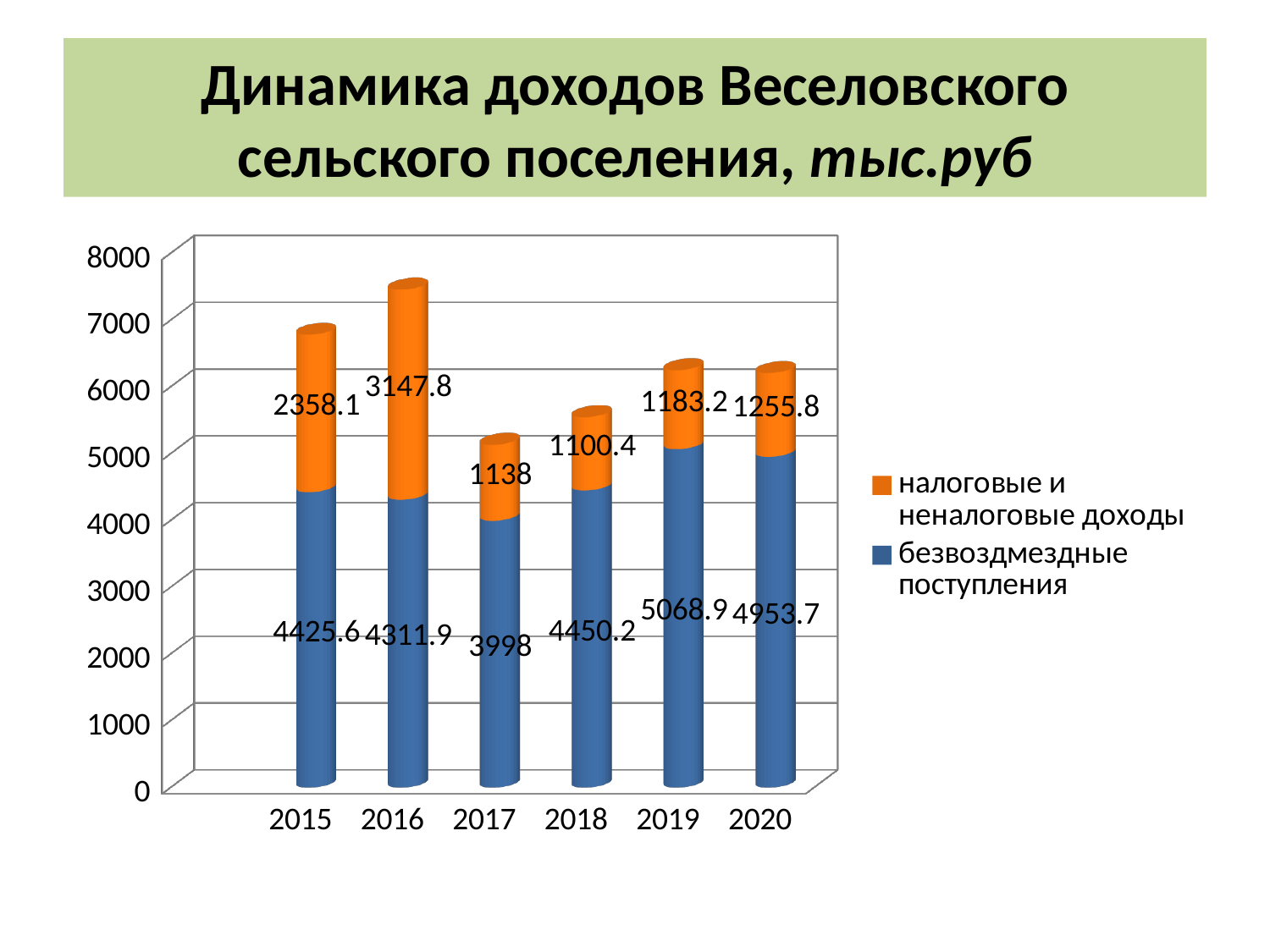
What is the total of the stacked bar for 2016? 7459.7 Which is larger: налоговые и неналоговые доходы in 2015 or in 2020? 2015 What is the value of безвозмездные поступления for 2017? 3998 Which year has the highest value of налоговые и неналоговые доходы? 2016 What is the value of налоговые и неналоговые доходы for 2016? 3147.8 How many series does the legend list? 2 What is the value of безвозмездные поступления for 2019? 5068.9 What kind of chart is shown on the slide? Stacked bar chart Which year has the lowest value of безвозмездные поступления? 2017 Which year has the lowest value of налоговые и неналоговые доходы? 2018 What is the difference between безвозмездные поступления in 2019 and in 2020? 115.2 How many years are shown on the x axis? 6